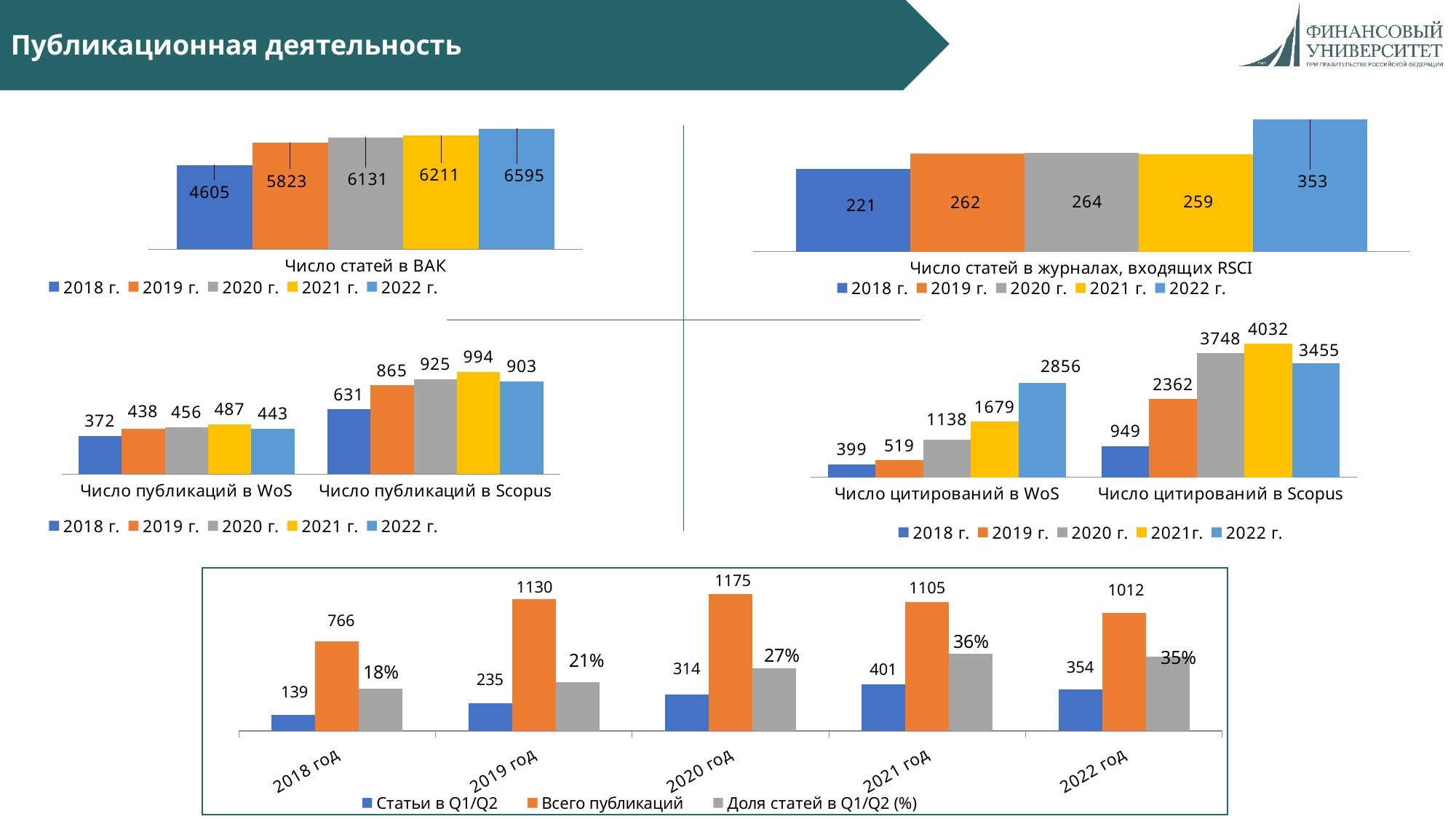
In the middle-right chart, do the values in the 'Число цитирований в WoS' group rise or fall from 2018 г. to 2022 г.? rise In the chart 'Число статей в журналах, входящих RSCI' (top right), what is the value for 2022 г.? 353 In the chart 'Число статей в журналах, входящих RSCI' (top right), what is the difference between the 2022 г. and 2018 г. values? 132 In the bottom chart, what is the value of 'Всего публикаций' for 2020 год? 1175 In the middle-left chart, which year has the highest value in the 'Число публикаций в WoS' group? 2021 г. In the chart 'Число статей в ВАК' (top left), which year has the lowest value? 2018 г. In the chart 'Число статей в ВАК' (top left), what is the value for 2022 г.? 6595 In the middle-right chart, which year has the highest value in the 'Число цитирований в Scopus' group? 2021г. In the middle-left chart, what is the value for 2021 г. in the 'Число публикаций в Scopus' group? 994 In the bottom chart, what is the value of 'Доля статей в Q1/Q2 (%)' for 2021 год? 36% How many series does the legend of the bottom chart list? 3 In the middle-right chart, what is the value for 2022 г. in the 'Число цитирований в WoS' group? 2856